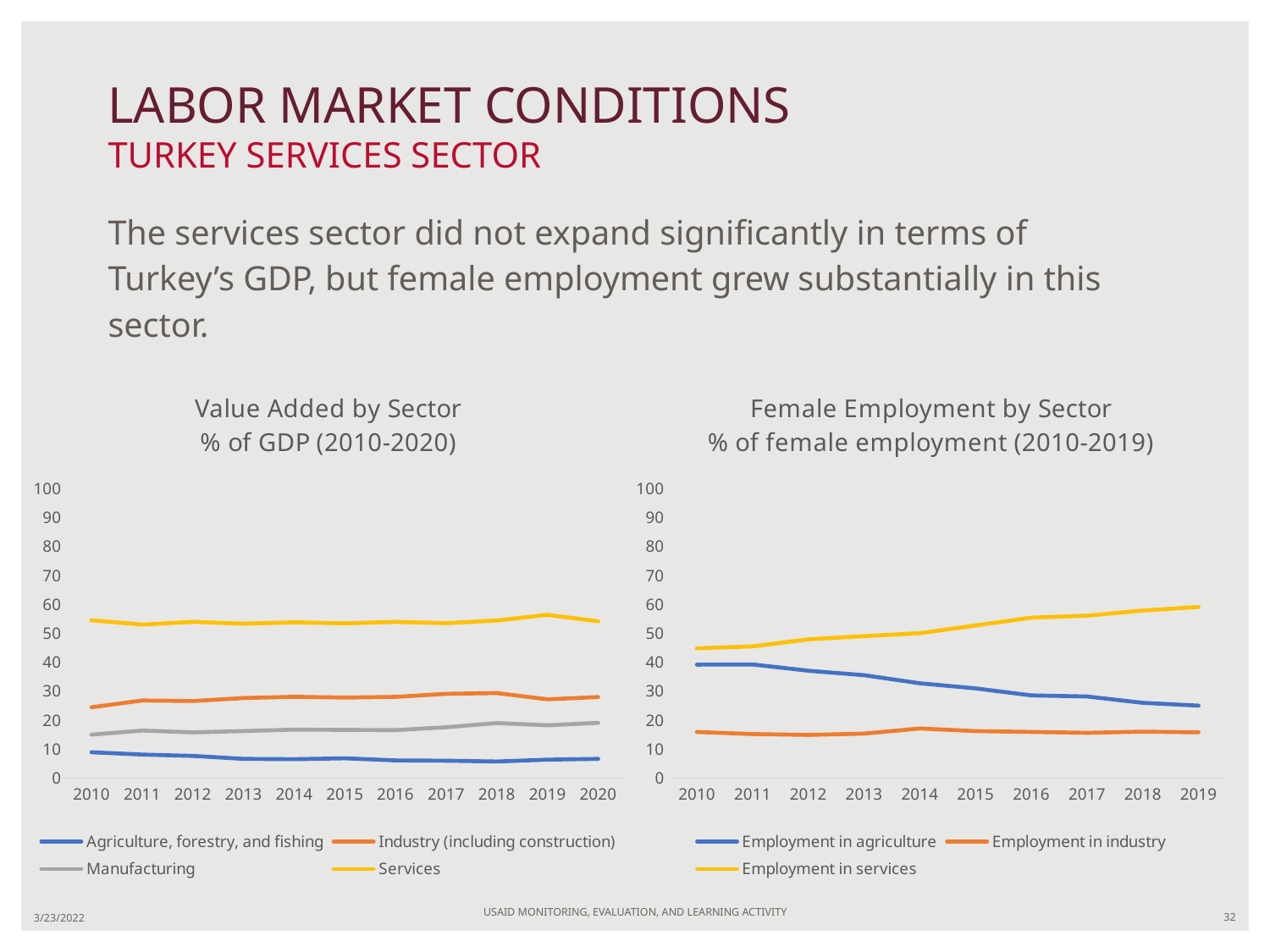
In the "Female Employment by Sector" chart, is the value for Employment in agriculture in 2019 greater or less than 30? less In the "Female Employment by Sector" chart, does the Employment in agriculture line rise or fall from 2010 to 2019? fall What kind of chart is the "Value Added by Sector" chart? line chart How many years are shown on the x axis of the "Value Added by Sector" chart? 11 In the "Female Employment by Sector" chart, which is larger in 2019: Employment in services or Employment in industry? Employment in services How many series does the legend of the "Value Added by Sector" chart list? 4 In the "Female Employment by Sector" chart, does the Employment in services line rise or fall from 2010 to 2019? rise In the "Value Added by Sector" chart, which series has the highest values across the period? Services In the "Value Added by Sector" chart, is the value for Services in 2010 greater or less than 50? greater How many series does the legend of the "Female Employment by Sector" chart list? 3 How many years are shown on the x axis of the "Female Employment by Sector" chart? 10 In the "Value Added by Sector" chart, which series has the lowest values across the period? Agriculture, forestry, and fishing